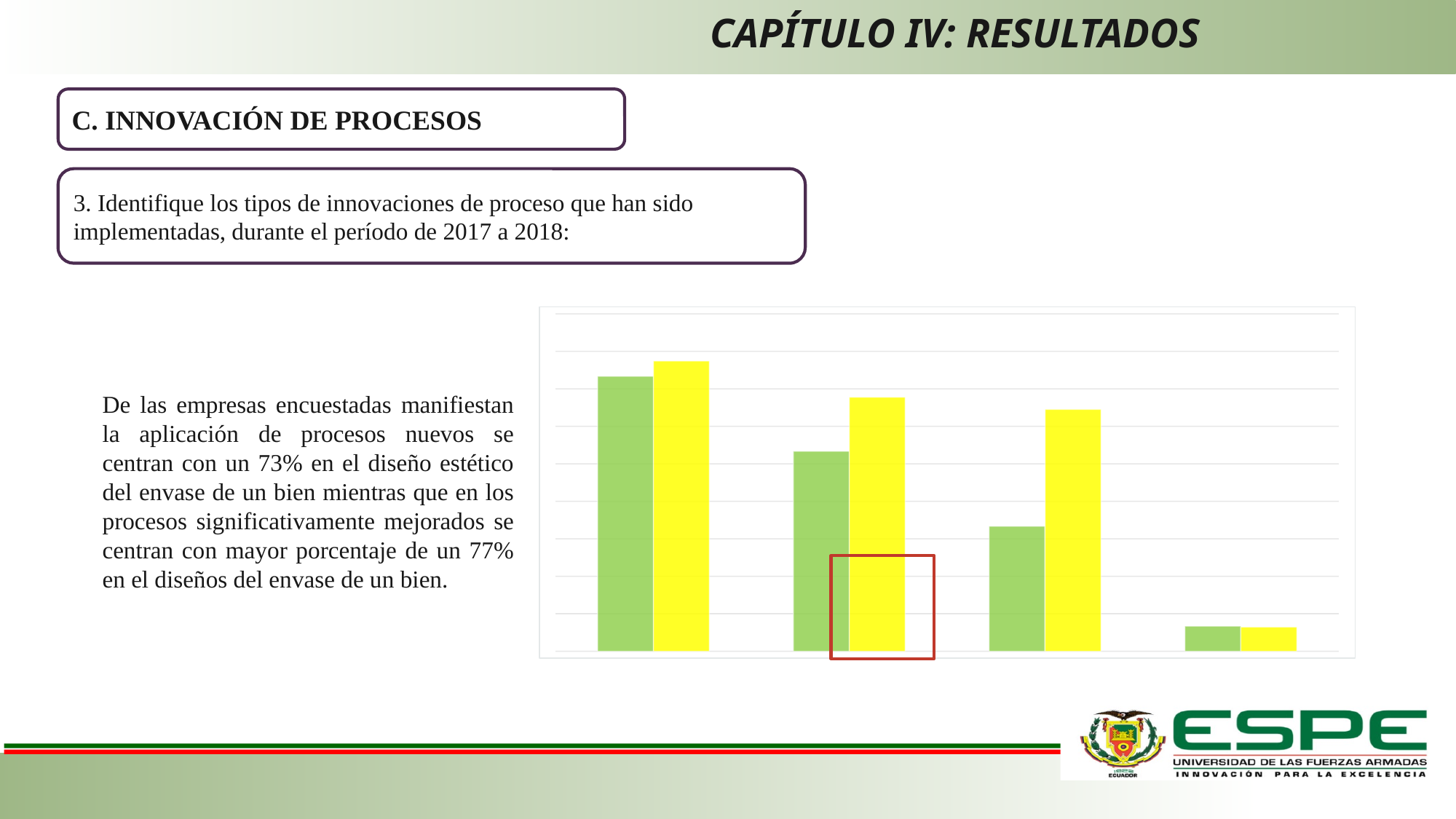
How many bars are plotted in each category group of the chart? 2 Which category group, counting from the left, has the shortest bars in the chart? the fourth What two colours are used for the bars in the chart? green and yellow In the second category group from the left, which bar is taller, the green one or the yellow one? the yellow one How many groups of bars (categories) does the chart show? 4 Does the chart display a legend? No Do the yellow bars rise or fall from left to right across the chart? fall What kind of chart is shown on the slide? bar chart In the third category group from the left, which bar is taller, the green one or the yellow one? the yellow one Which category group, counting from the left, has the tallest bars in the chart? the first Do the green bars rise or fall from left to right across the chart? fall